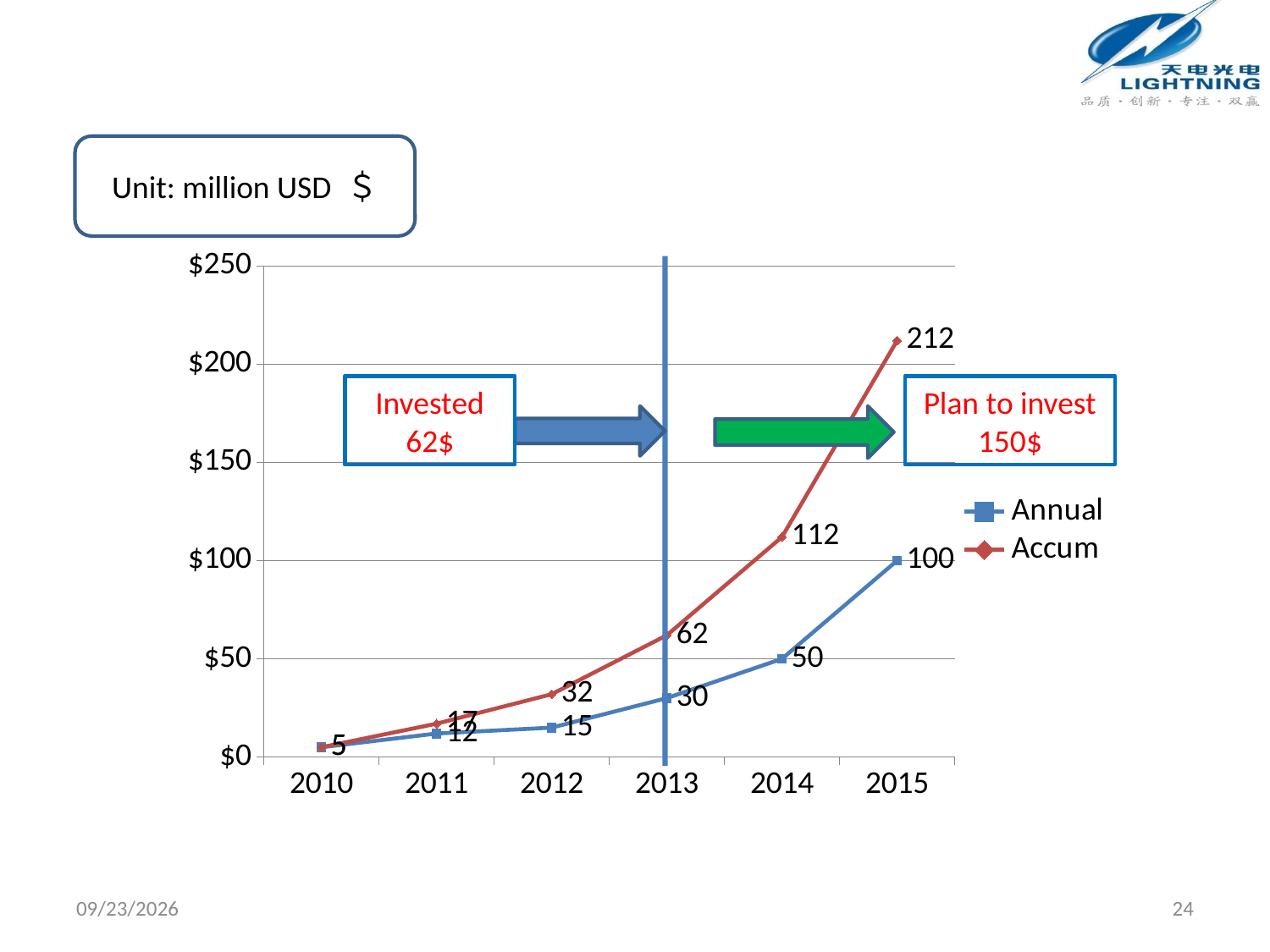
Which is larger in 2014, the Annual value or the Accum value? Accum How many series does the legend list? 2 What is the difference between the Accum and Annual values in 2015? 112 What is the Annual value for 2015? 100 How many years are shown on the x axis? 6 What kind of chart is shown on the slide? Line chart What is the Accum value for 2014? 112 What is the Annual value for 2014? 50 What is the Annual value for 2012? 15 What is the Accum value for 2015? 212 What is the Accum value for 2013? 62 In which year is the Accum series highest? 2015